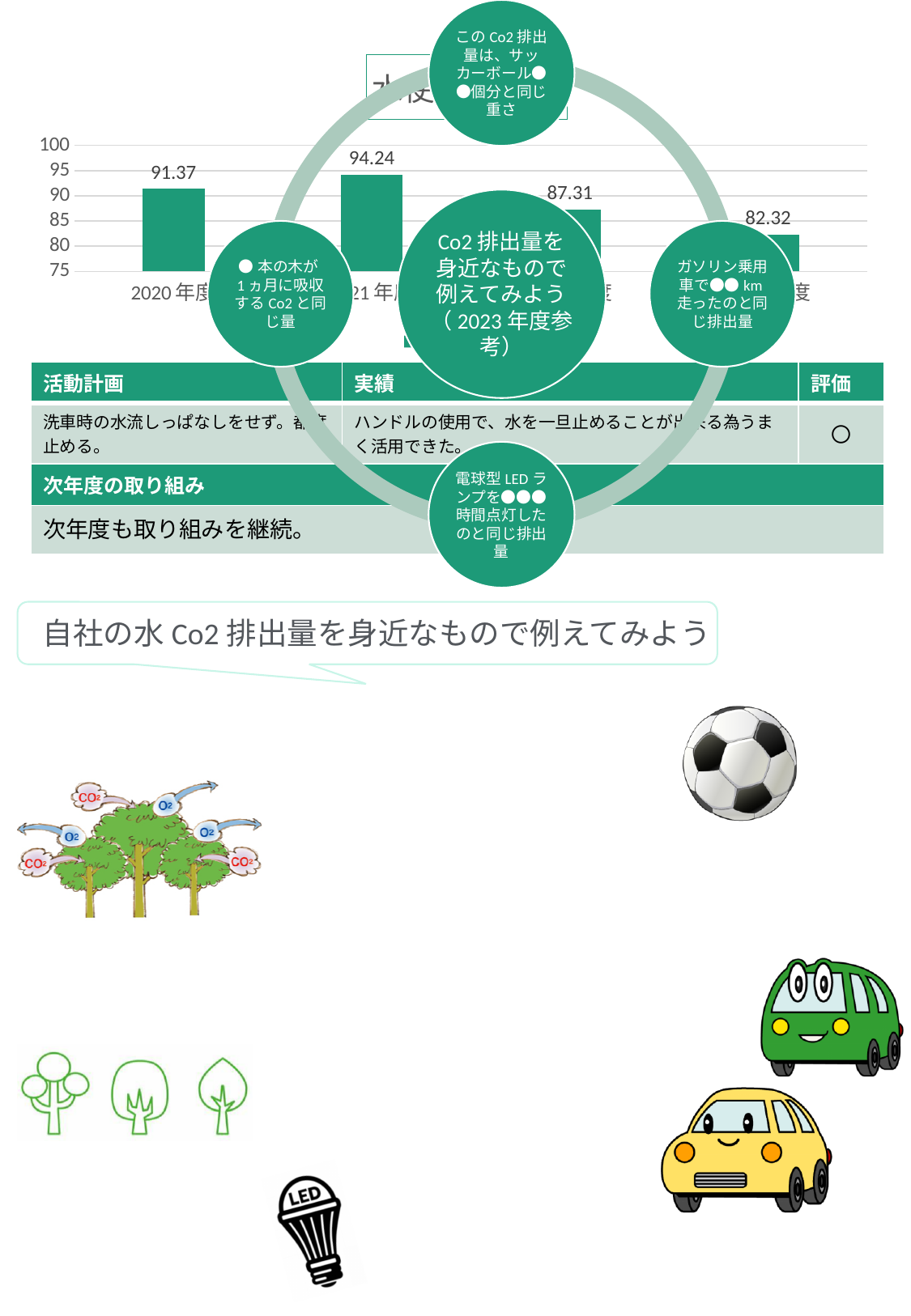
What is the lowest tick value shown on the vertical axis of the chart? 75 Which is larger: the value for 2020 年度 or the value of the rightmost bar? 2020 年度 What is the value of the rightmost bar in the chart? 82.32 What is the lowest value shown in the bar chart? 82.32 How many bars are plotted in the chart? 4 Is the value of the rightmost bar greater or less than 85? less What is the highest value shown in the bar chart? 94.24 What is the difference between the highest value and the value for 2020 年度? 2.87 What is the value for 2020 年度 in the bar chart? 91.37 From the second bar onward, do the values rise or fall along the x axis? fall What is the difference between the highest and lowest values in the chart? 11.92 What kind of chart is shown at the top of the slide? bar chart